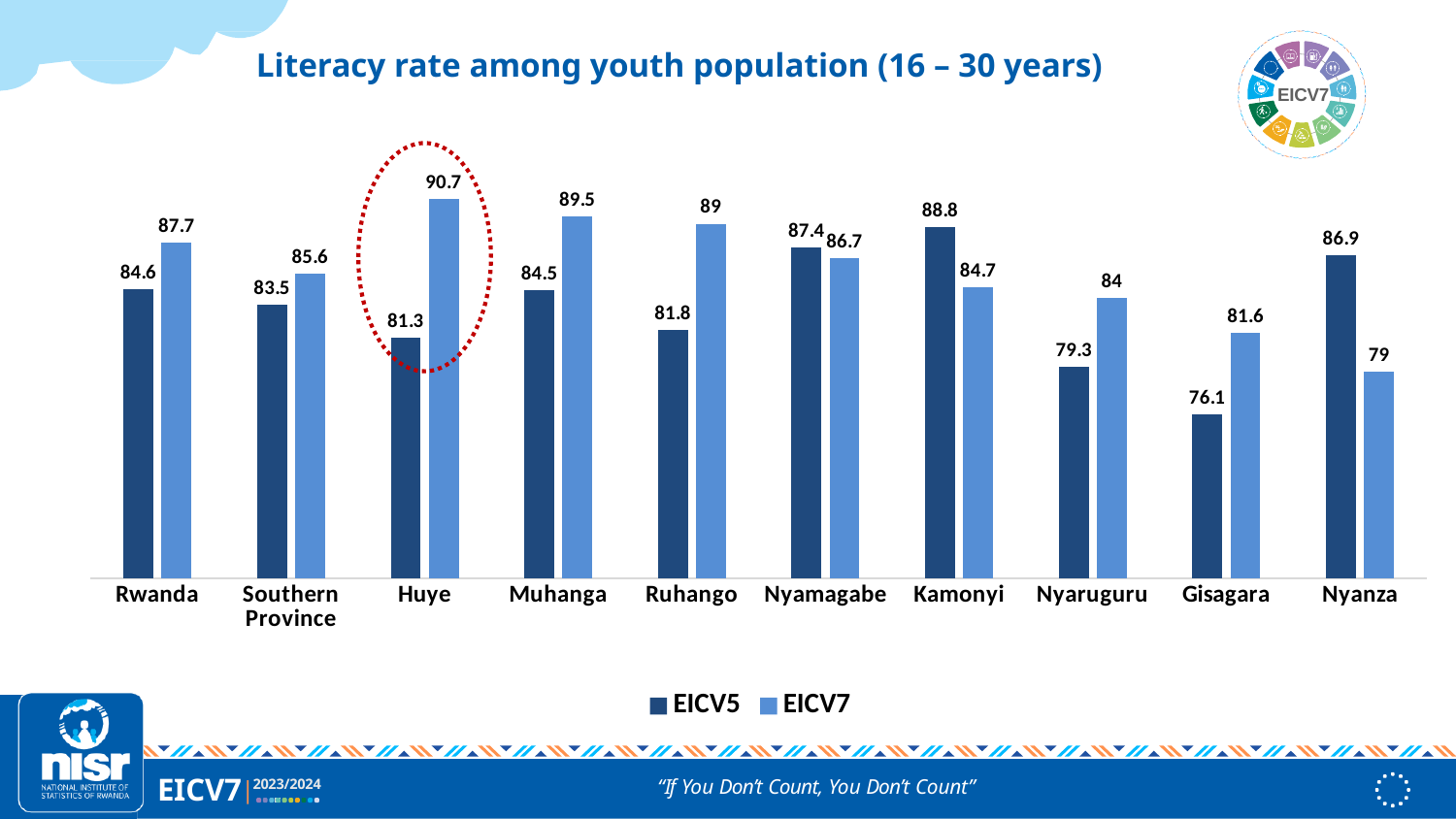
What is the EICV7 value for Southern Province? 85.6 Which category has the highest EICV7 literacy rate? Huye What kind of chart is shown on the slide? Bar chart Which category has the lowest EICV5 literacy rate? Gisagara What is the difference between the EICV5 and EICV7 values for Nyanza? 7.9 How many categories are shown on the x axis? 10 What is the EICV7 literacy rate for Huye? 90.7 What is the EICV5 literacy rate for Gisagara? 76.1 Which category has the lowest EICV7 literacy rate? Nyanza For Kamonyi, which is larger: the EICV5 value or the EICV7 value? EICV5 What is the difference between the EICV7 and EICV5 values for Huye? 9.4 How many series does the legend list? 2